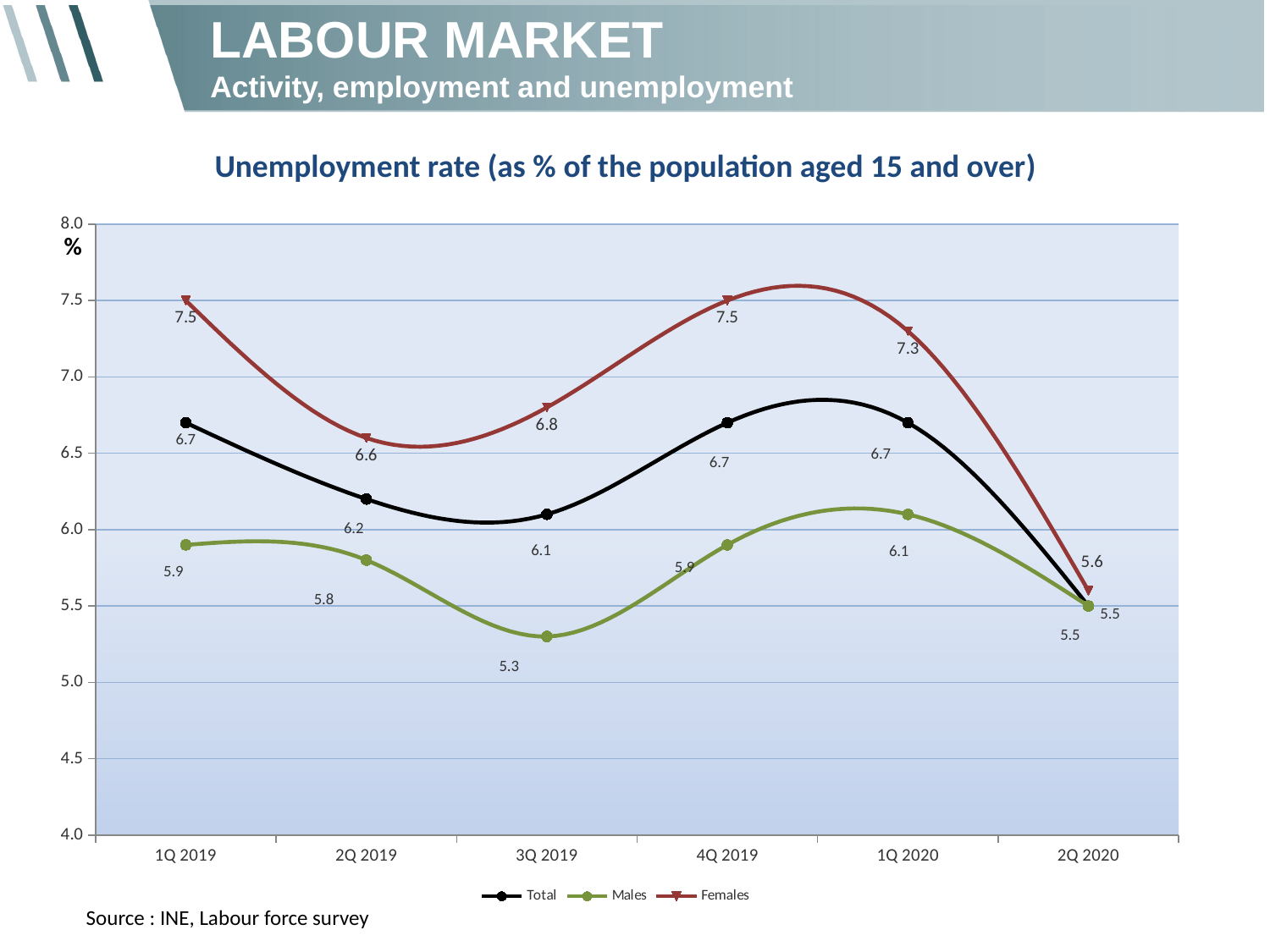
How many quarters are plotted along the x axis? 6 How many series does the legend list? 3 What is the Total unemployment rate in 2Q 2020? 5.5 What is the unemployment rate for Females in 1Q 2019? 7.5 In which quarter is the Males unemployment rate lowest? 3Q 2019 Does the Females unemployment rate rise or fall from 1Q 2020 to 2Q 2020? fall What is the difference between the Females and Males unemployment rates in 1Q 2019? 1.6 What is the unemployment rate for Males in 3Q 2019? 5.3 What type of chart is shown on the slide? line chart What is the source cited below the chart? INE, Labour force survey In which quarter is the Females unemployment rate lowest? 2Q 2020 Which is higher in 4Q 2019, the Females rate or the Total rate? Females